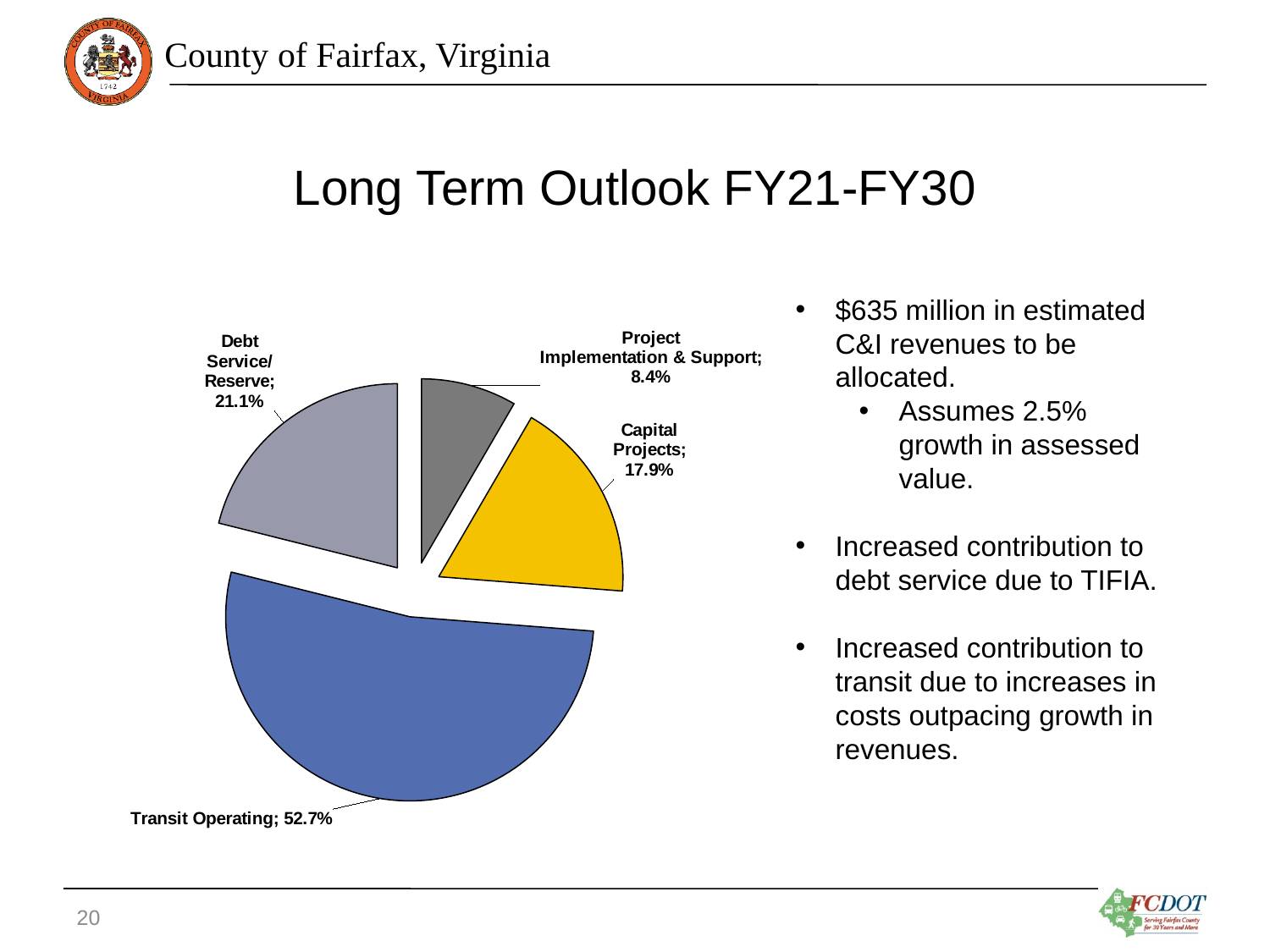
Which slice of the pie is the smallest? Project Implementation & Support What share of the pie does Debt Service/Reserve represent? 21.1% What share of the pie does Project Implementation & Support represent? 8.4% What is the difference in percentage points between the Transit Operating slice and the Debt Service/Reserve slice? 31.6 percentage points What is the difference in percentage points between the Capital Projects slice and the Project Implementation & Support slice? 9.5 percentage points What type of chart is shown on the slide? Pie chart How many slices does the pie chart have? 4 Which slice of the pie is the largest? Transit Operating Which is larger, the Debt Service/Reserve slice or the Capital Projects slice? Debt Service/Reserve What share of the pie does Capital Projects represent? 17.9% What colour is the Transit Operating slice? Blue What share of the pie does Transit Operating represent? 52.7%